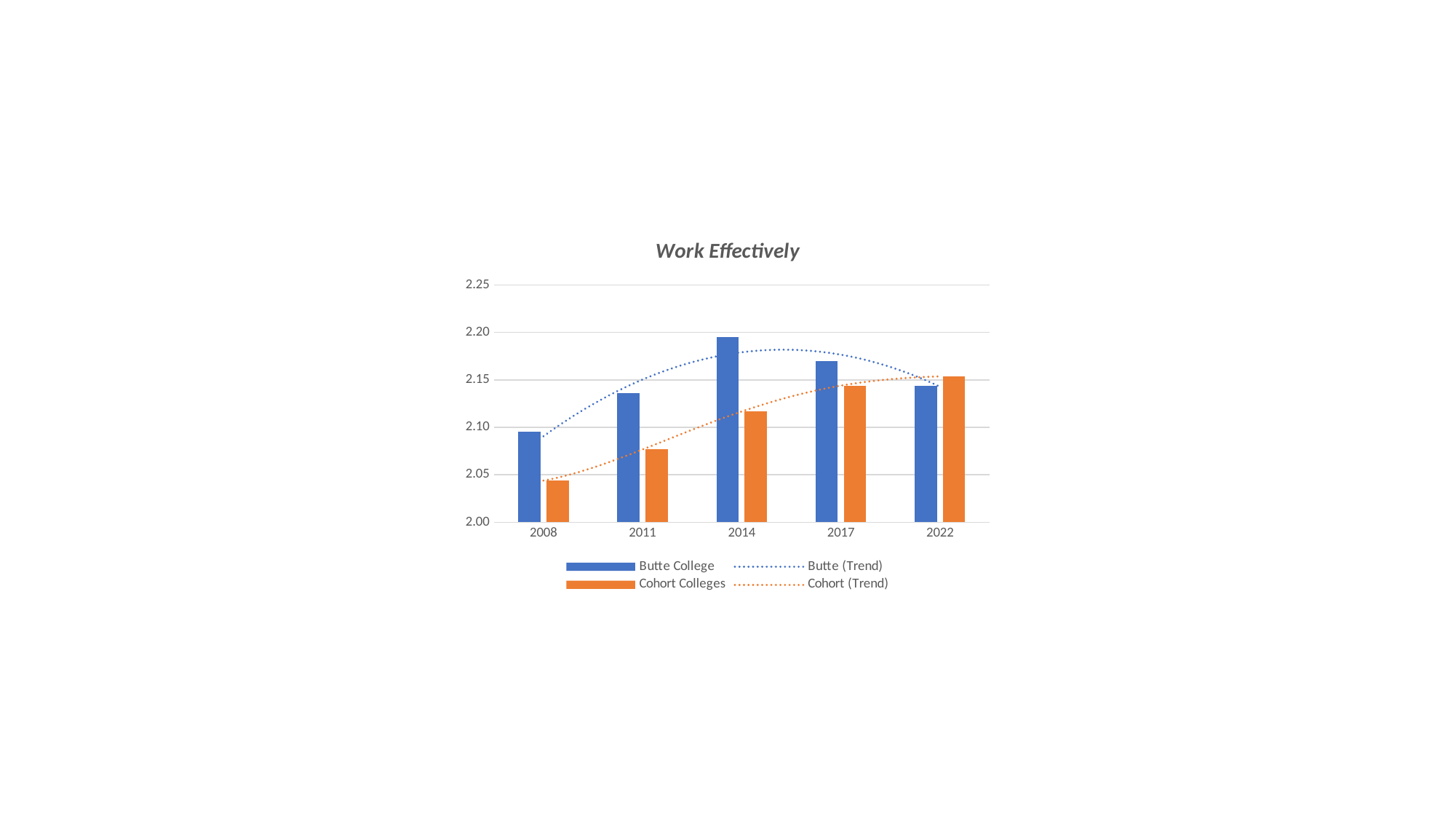
How many years are shown on the x axis? 5 Is the Butte College value for 2014 greater or less than 2.15? greater In 2008, which is larger: Butte College or Cohort Colleges? Butte College In which year is the Butte College value highest? 2014 Is the Cohort Colleges value for 2008 greater or less than 2.05? less What is the title of the chart? Work Effectively In which year is the Cohort Colleges value lowest? 2008 Do the Cohort Colleges values rise or fall from 2008 to 2022? rise How many entries does the legend list? 4 What kind of chart is shown on the slide? Bar chart In which year is the Cohort Colleges value highest? 2022 In 2022, which is larger: Butte College or Cohort Colleges? Cohort Colleges